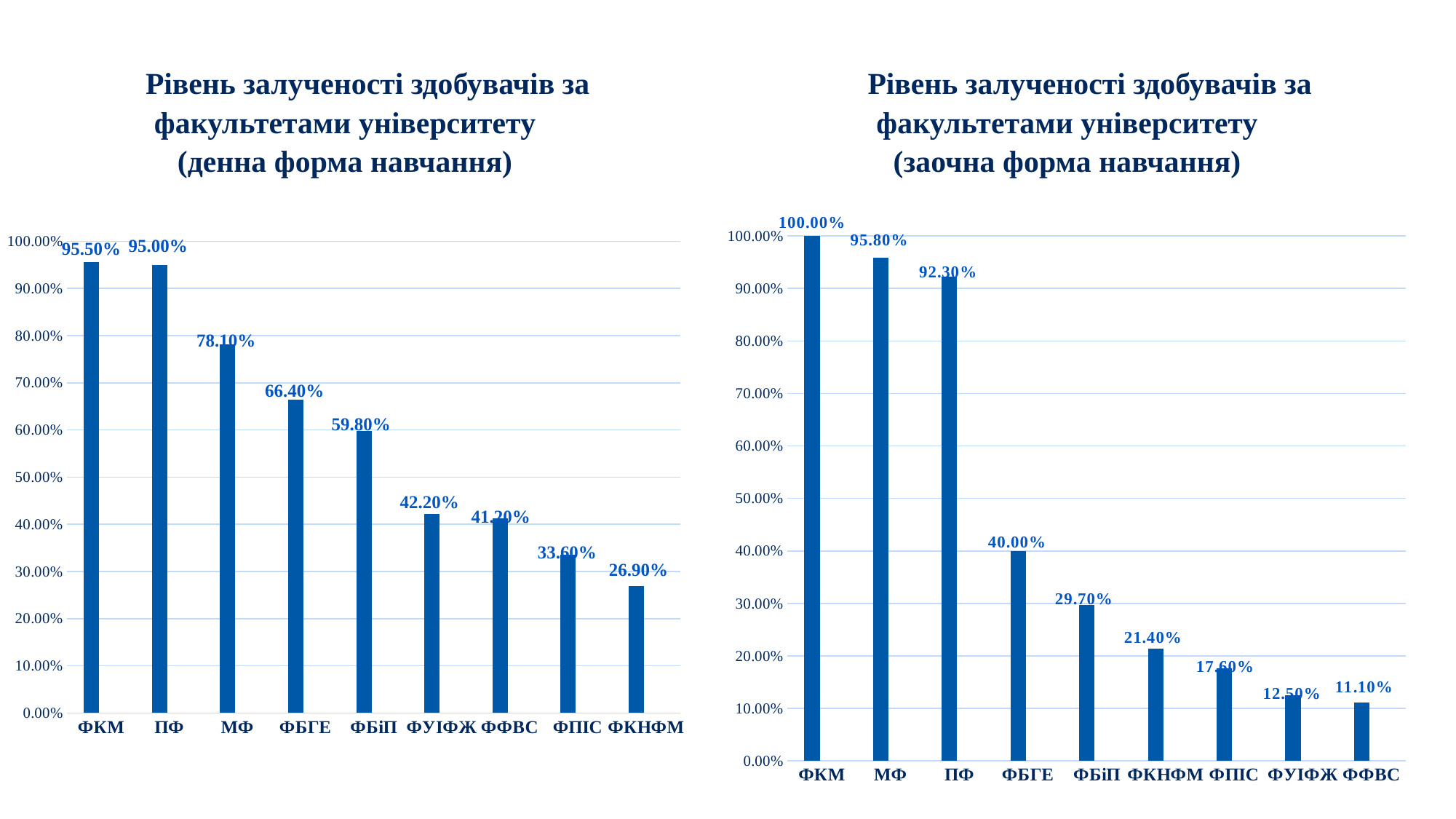
How many faculties are shown in the left chart (денна форма навчання)? 9 In the left chart (денна форма навчання), what is the difference between the values for ФБГЕ and ФБіП? 6.60% What type of chart is the right chart (заочна форма навчання)? bar chart In the right chart (заочна форма навчання), is the value for ФБіП greater or less than 40.00%? less In the right chart (заочна форма навчання), what is the difference between the values for ФКМ and ПФ? 7.70% In the left chart (денна форма навчання), which faculty has the lowest value? ФКНФМ In the right chart (заочна форма навчання), which faculty has the highest value? ФКМ In the left chart (денна форма навчання), do the values rise or fall from left to right along the x axis? fall In the right chart (заочна форма навчання), which faculty has the lowest value? ФФВС In the left chart (денна форма навчання), which is larger, the value for ФУІФЖ or the value for ФПІС? ФУІФЖ In the left chart (денна форма навчання), what is the value for МФ? 78.10% In the right chart (заочна форма навчання), what is the value for ФБГЕ? 40.00%